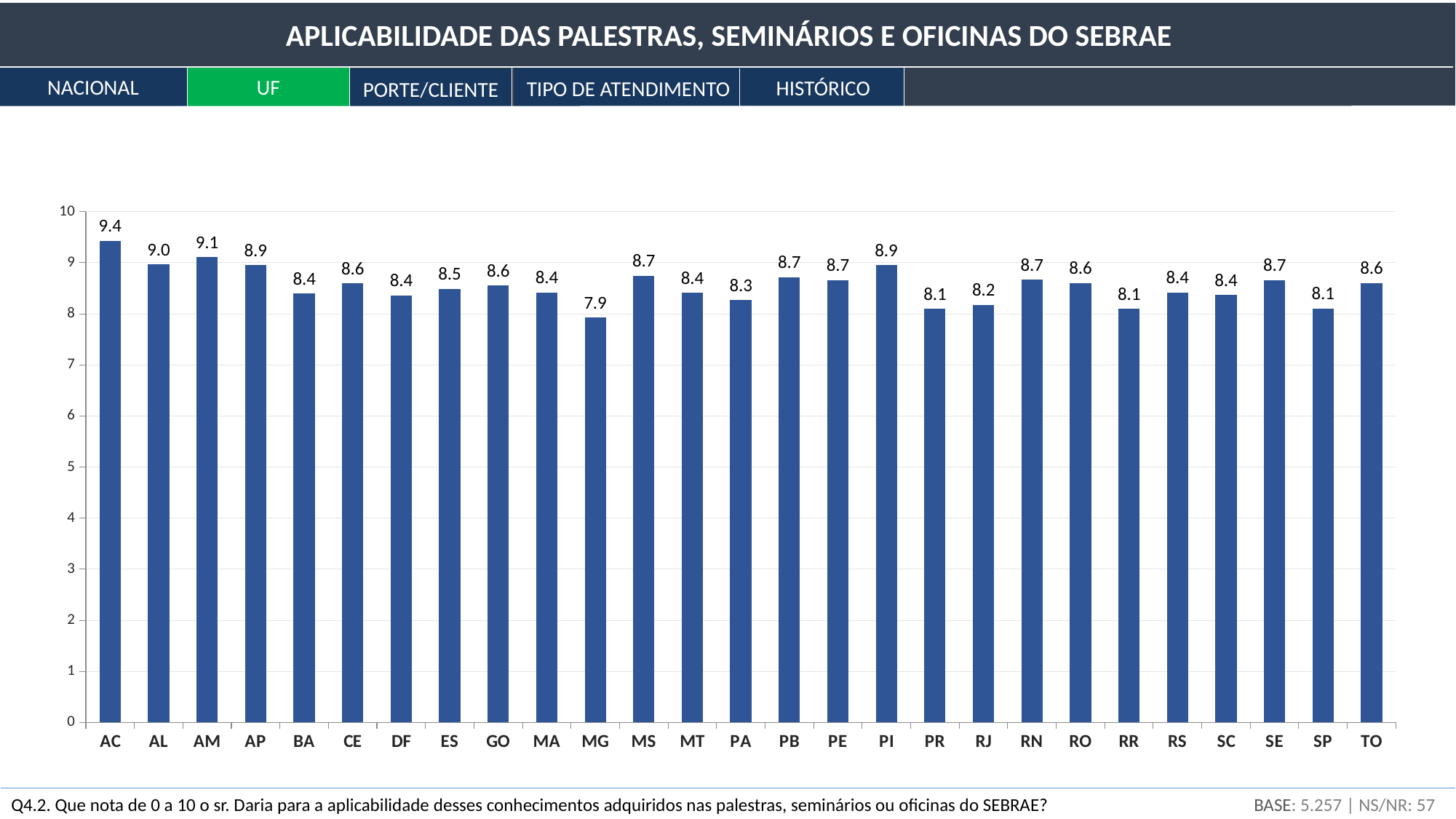
What is the value for MG? 7.9 What is the value for PI? 8.9 What is the title of the slide? APLICABILIDADE DAS PALESTRAS, SEMINÁRIOS E OFICINAS DO SEBRAE Which is larger, the value for AM or the value for PA? AM How many UF categories are shown on the x axis? 27 What is the difference between the values for AC and MG? 1.5 What is the value for AC? 9.4 What is the value for SP? 8.1 Is the value for RJ greater or less than 9? less What kind of chart is shown on the slide? bar chart Which UF has the highest value? AC Which UF has the lowest value? MG